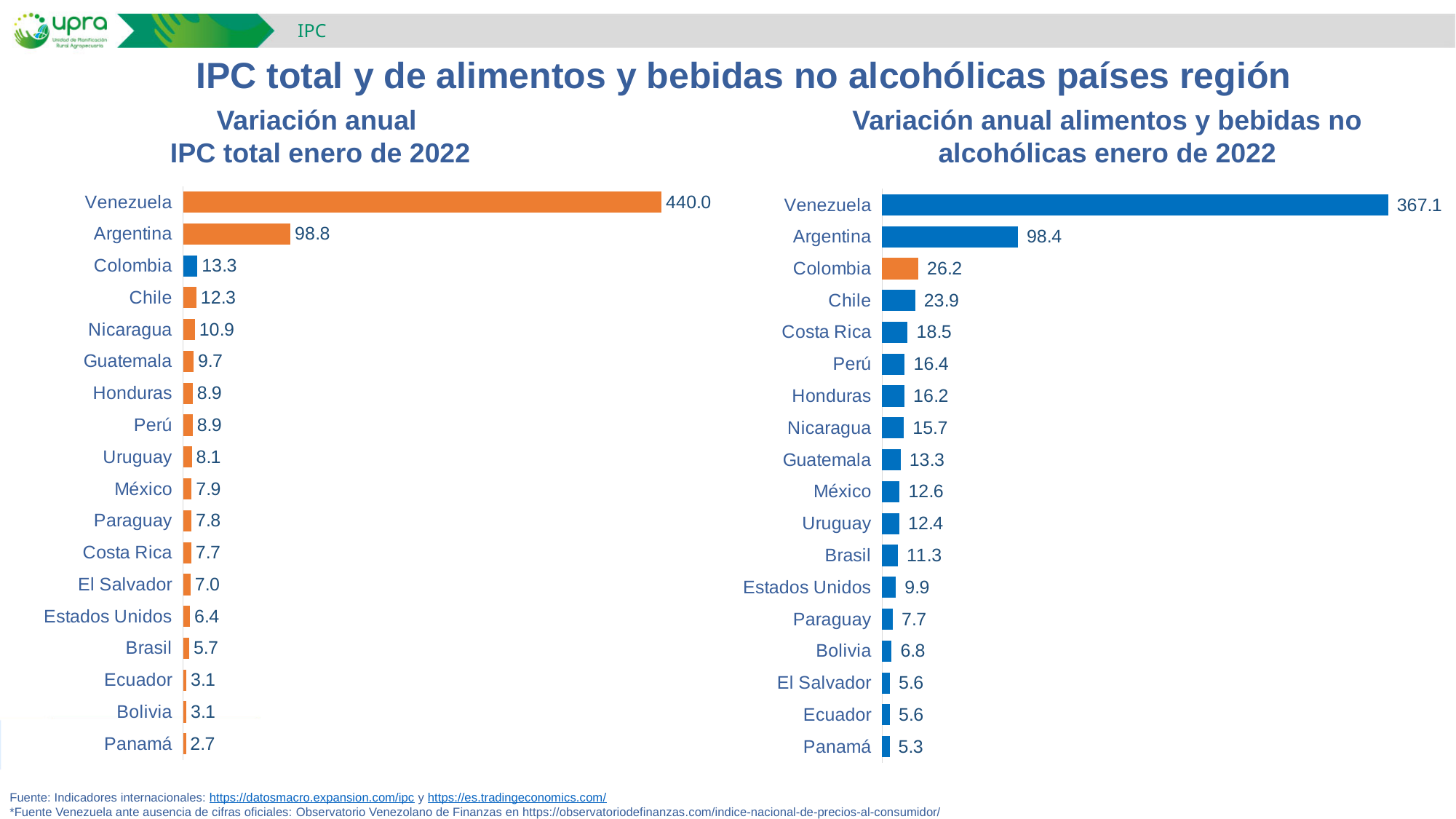
In the 'Variación anual alimentos y bebidas no alcohólicas enero de 2022' chart, which country has the lowest value? Panamá How many countries are shown in the 'Variación anual IPC total enero de 2022' chart? 18 What type of chart is the 'Variación anual IPC total enero de 2022' chart? Bar chart In the 'Variación anual IPC total enero de 2022' chart, what is the difference between the values for Venezuela and Argentina? 341.2 How many countries are shown in the 'Variación anual alimentos y bebidas no alcohólicas enero de 2022' chart? 18 In the 'Variación anual alimentos y bebidas no alcohólicas enero de 2022' chart, what is the value for Colombia? 26.2 In the 'Variación anual IPC total enero de 2022' chart, which country has the highest value? Venezuela In the 'Variación anual IPC total enero de 2022' chart, which is larger, the value for Chile or the value for Nicaragua? Chile In the 'Variación anual alimentos y bebidas no alcohólicas enero de 2022' chart, what is the difference between the values for Chile and Costa Rica? 5.4 In the 'Variación anual IPC total enero de 2022' chart, what is the value for Colombia? 13.3 In the 'Variación anual alimentos y bebidas no alcohólicas enero de 2022' chart, what is the value for Venezuela? 367.1 In the 'Variación anual alimentos y bebidas no alcohólicas enero de 2022' chart, which is larger, the value for Brasil or the value for Estados Unidos? Brasil